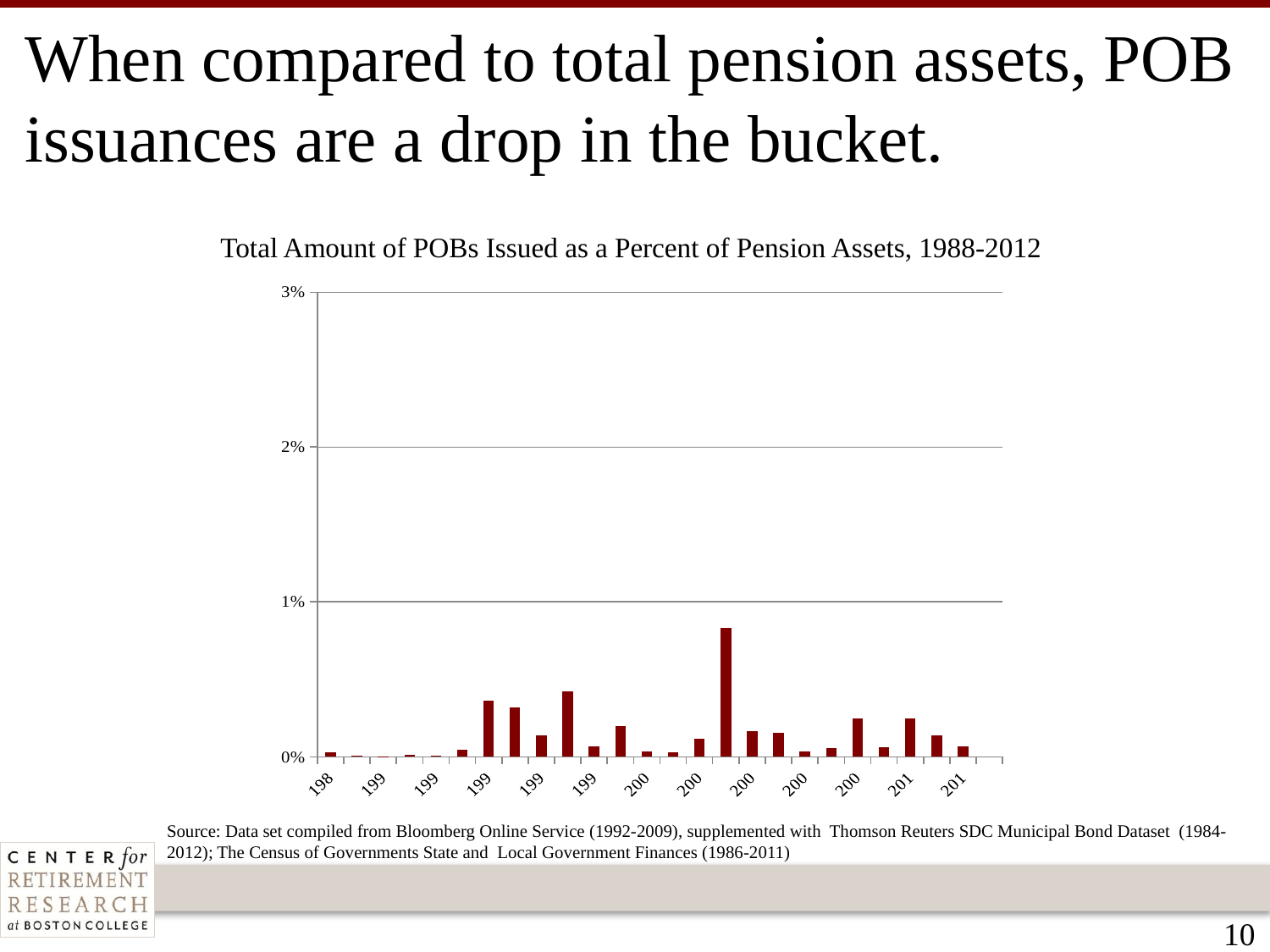
Is the value of the tallest bar in the chart greater or less than 1%? less Is the value for the first bar on the left greater or less than 1%? less What kind of chart is shown on the slide? bar chart What is the title of the chart? Total Amount of POBs Issued as a Percent of Pension Assets, 1988-2012 Is the highest value in the chart greater or less than 2%? less What is the highest tick label shown on the y-axis? 3% How many years (bars) does the chart cover, according to its title? 25